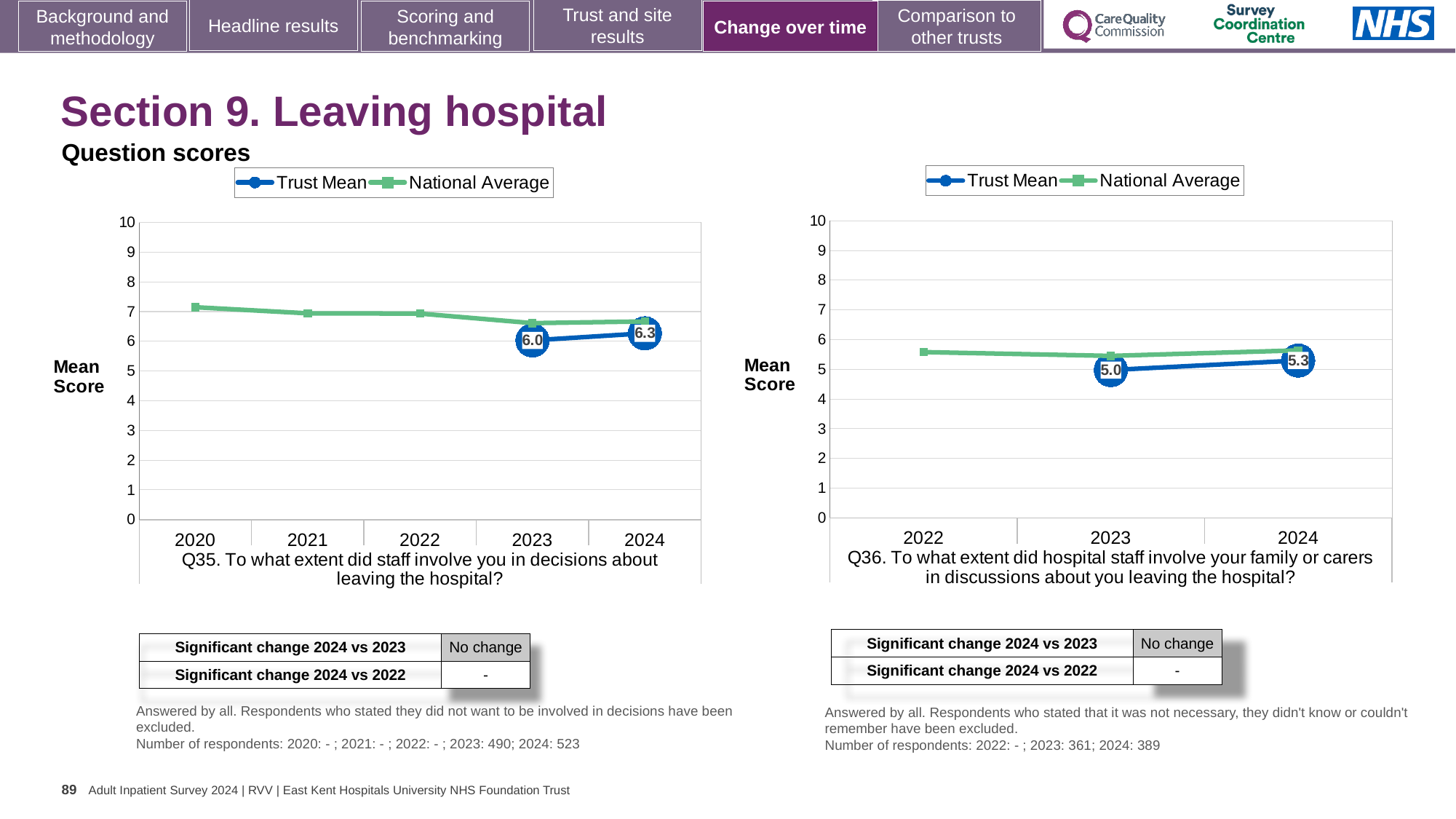
On the Q36 chart (right), is the National Average for 2022 greater or less than 5? greater On the Q35 chart (left), what is the Trust Mean score for 2023? 6.0 On the Q36 chart (right), which year has the higher Trust Mean, 2023 or 2024? 2024 On the Q36 chart (right), what is the difference between the Trust Mean for 2024 and 2023? 0.3 What kind of chart is the Q36 chart (right)? Line chart How many series does the legend of the Q35 chart (left) list? 2 On the Q36 chart (right), how many years are shown on the x axis? 3 On the Q36 chart (right), what is the Trust Mean score for 2023? 5.0 On the Q35 chart (left), what is the Trust Mean score for 2024? 6.3 On the Q35 chart (left), how many years are shown on the x axis? 5 On the Q35 chart (left), by how much did the Trust Mean change from 2023 to 2024? 0.3 On the Q36 chart (right), what is the Trust Mean score for 2024? 5.3